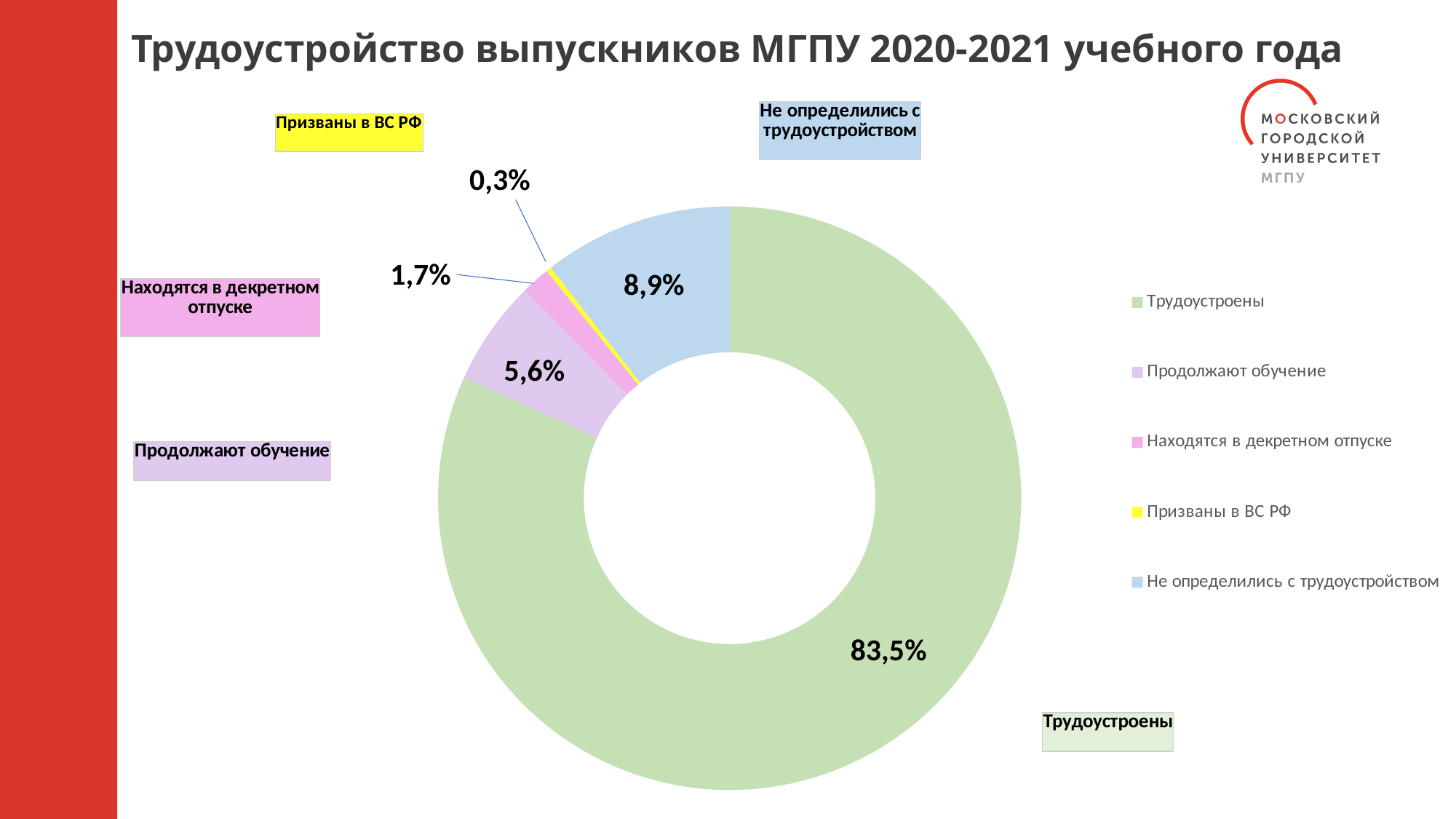
What is the value for Призваны в ВС РФ? 0,3% What percentage of graduates are Находятся в декретном отпуске? 1,7% What share of graduates are shown as Трудоустроены? 83,5% What is the value for Продолжают обучение? 5,6% Which is larger: the share for Продолжают обучение or the share for Находятся в декретном отпуске? Продолжают обучение What kind of chart is shown on the slide? doughnut chart What is the difference between the shares for Трудоустроены and Не определились с трудоустройством? 74,6% Which category has the largest share of the chart? Трудоустроены What percentage of graduates are Не определились с трудоустройством? 8,9% How many categories does the chart show? 5 What is the difference between the shares for Не определились с трудоустройством and Продолжают обучение? 3,3% Which category has the smallest share of the chart? Призваны в ВС РФ